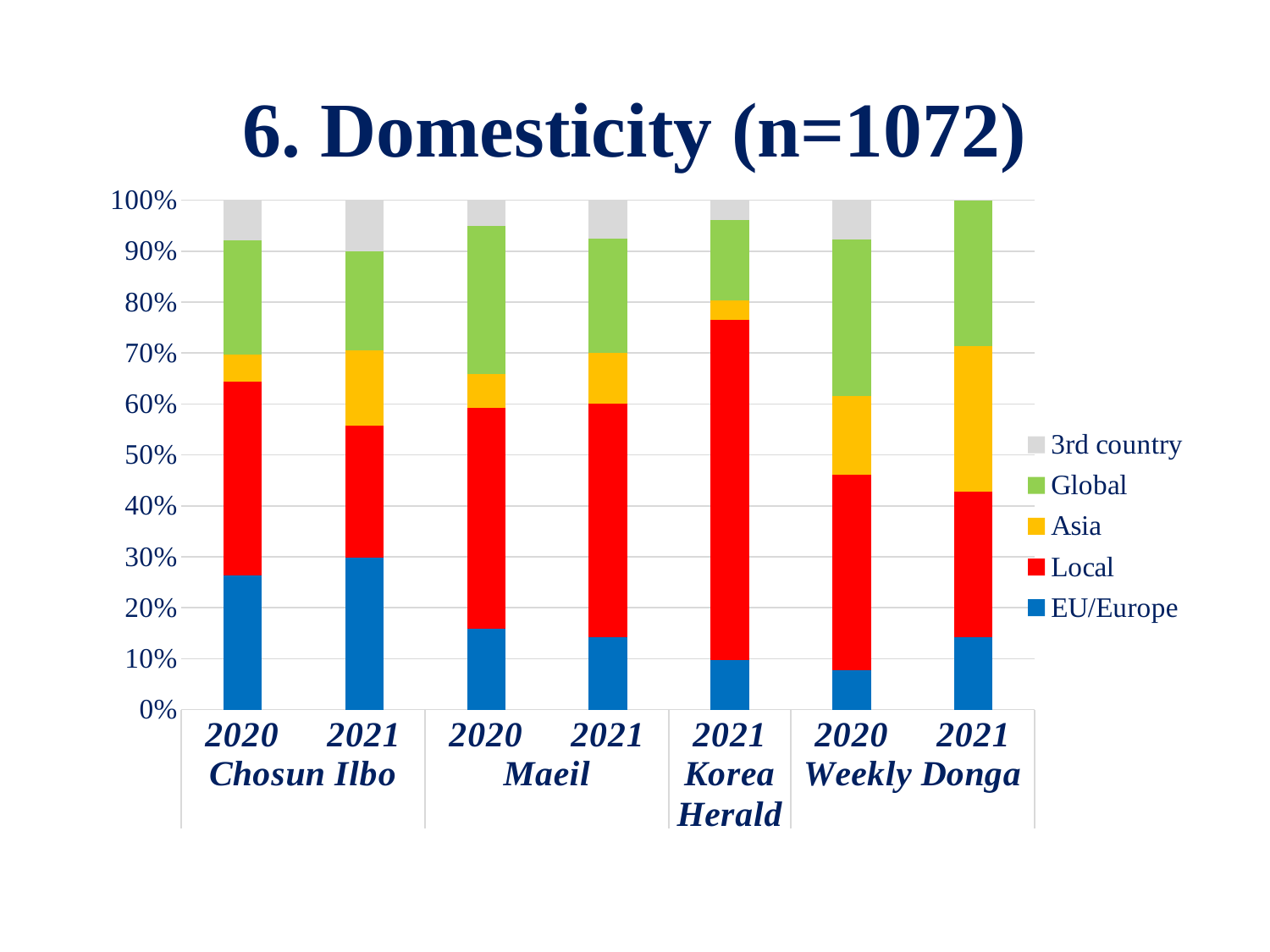
What is the title of the chart? 6. Domesticity (n=1072) Which bar has the smallest Asia segment? Korea Herald 2021 How many series does the legend list? 5 What kind of chart is shown on the slide? Stacked bar chart Which bar has the largest Asia segment? Weekly Donga 2021 Is the EU/Europe share for Chosun Ilbo 2020 greater or less than 20%? greater Which bar has no visible 3rd country segment? Weekly Donga 2021 For Chosun Ilbo, is the EU/Europe share larger in 2020 or 2021? 2021 Which colour represents the Local series in the chart? Red Which bar has the largest Local segment? Korea Herald 2021 How many stacked bars are plotted in the chart? 7 Is the EU/Europe share for Weekly Donga 2020 greater or less than 10%? less